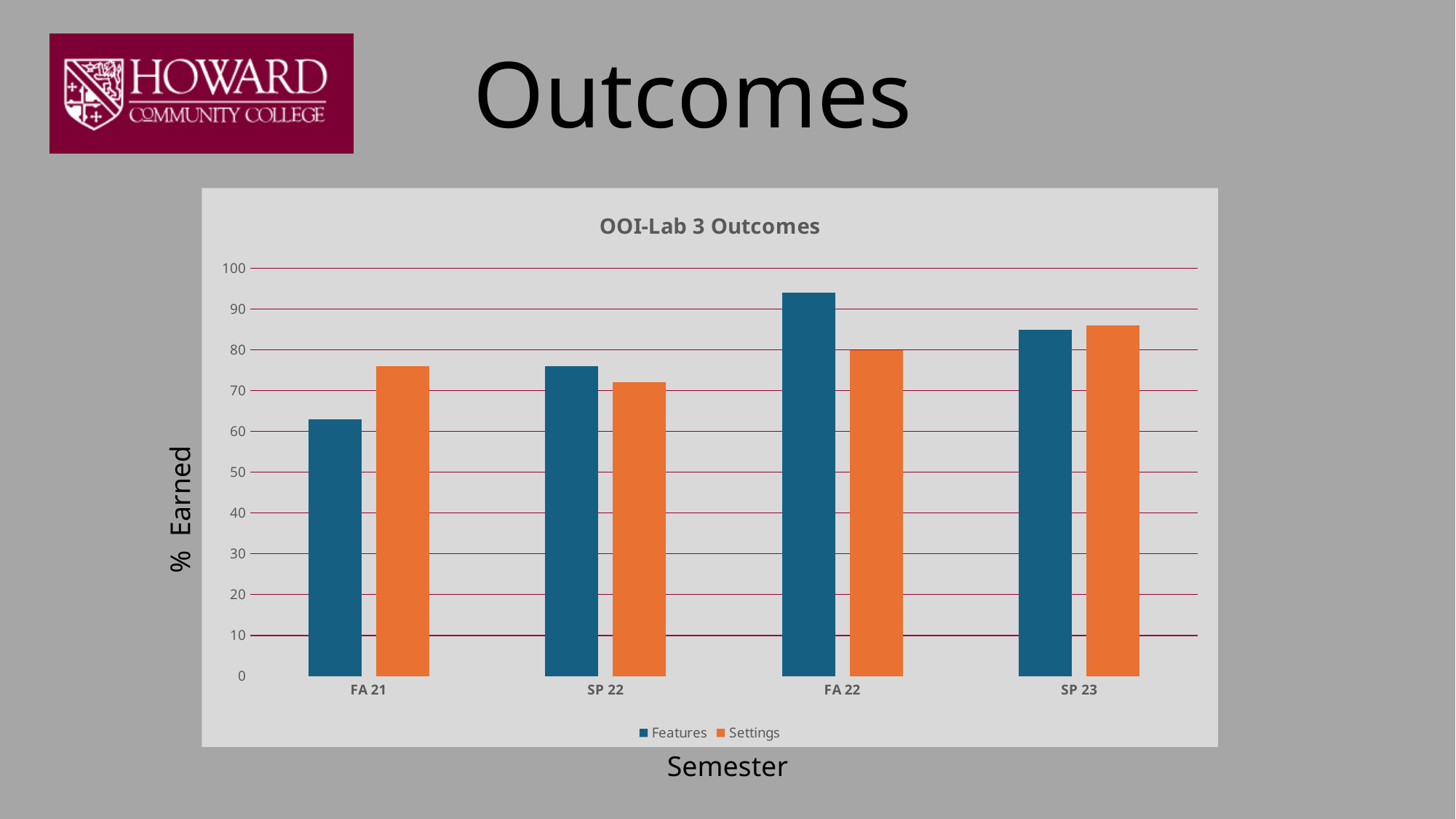
What kind of chart is shown on the slide? bar chart How many series does the legend list in the OOI-Lab 3 Outcomes chart? 2 In FA 22, which is larger, Features or Settings? Features Which semester has the highest value for Features? FA 22 In FA 21, which is larger, Features or Settings? Settings What is the label of the y axis in the OOI-Lab 3 Outcomes chart? % Earned Is the value for Features in FA 21 greater or less than 70? less Is the value for Settings in SP 23 greater or less than 80? greater Which semester has the lowest value for Features? FA 21 Which semester has the lowest value for Settings? SP 22 How many semesters are shown on the x axis of the OOI-Lab 3 Outcomes chart? 4 Is the value for Features in FA 22 greater or less than 90? greater